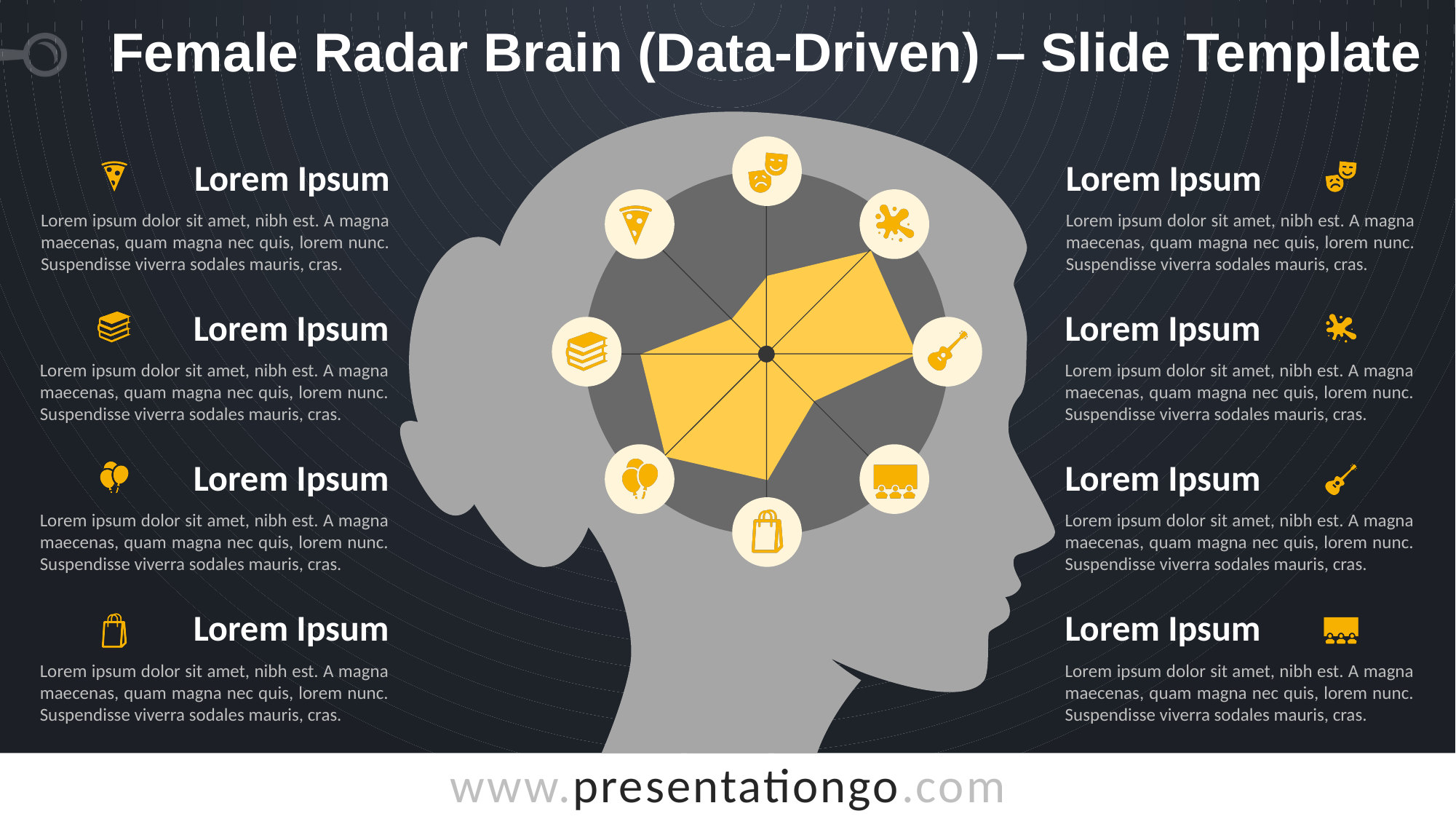
What colour is the filled data area of the radar chart? yellow How are the categories of the radar chart labelled? with icons in circles Which axis of the radar chart has the lowest value? the pizza axis (top left) How many data series are plotted on the radar chart? 1 How many axes (categories) does the radar chart have? 8 What kind of chart is shown inside the head silhouette? radar chart On the radar chart, which is larger: the value on the paint splash axis or the value on the theater masks axis? paint splash